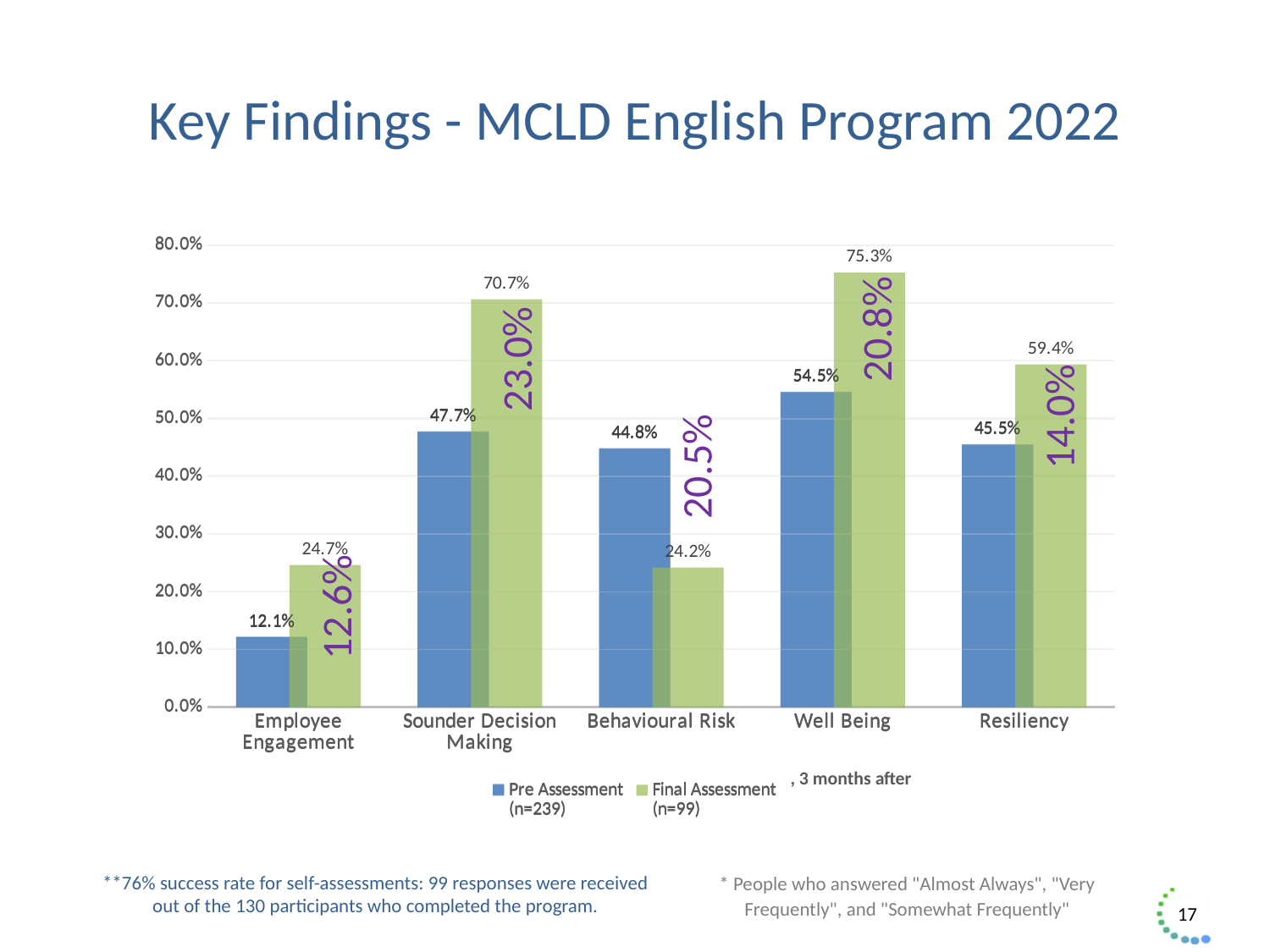
What is the Pre Assessment value for Employee Engagement? 12.1% Which category has the lowest Final Assessment value? Behavioural Risk What is the sample size (n) given in the legend for the Final Assessment series? n=99 How many series does the legend list? 2 Is the Pre Assessment value for Sounder Decision Making greater or less than 50.0%? less What is the Final Assessment value for Well Being? 75.3% What kind of chart is shown on the slide? Bar chart What is the difference between the Final Assessment and Pre Assessment values for Resiliency? 13.9% Which category has the highest Pre Assessment value? Well Being What is the Final Assessment value for Sounder Decision Making? 70.7% How many categories are shown on the x axis? 5 Which is larger for Behavioural Risk: the Pre Assessment value or the Final Assessment value? Pre Assessment